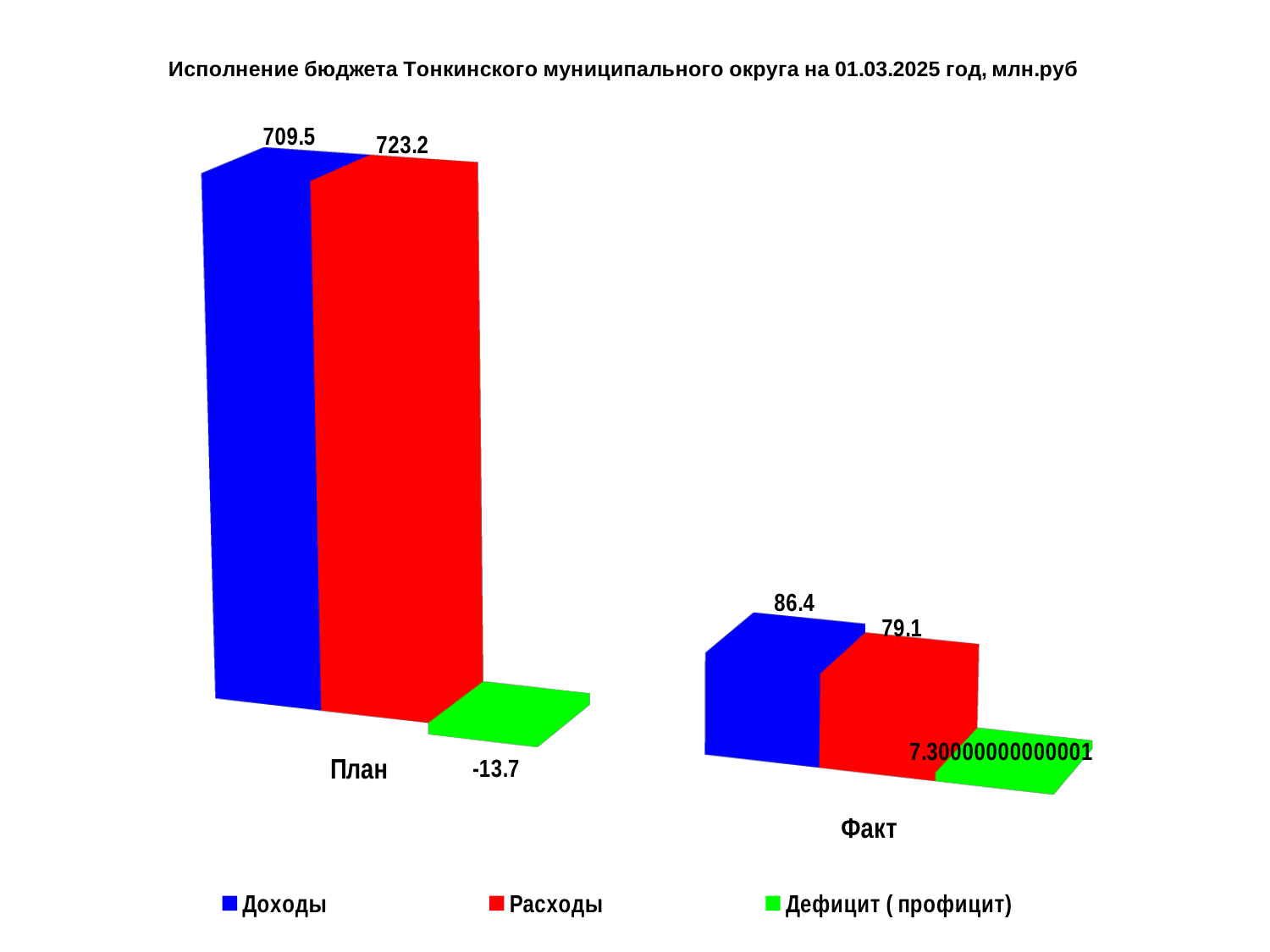
What is the value of Расходы for План? 723.2 What type of chart is shown on the slide? Bar chart What is the value of Дефицит ( профицит) for План? -13.7 What is the value of Расходы for Факт? 79.1 How many series does the legend list? 3 Which series has the lowest value in the Факт category? Дефицит ( профицит) Which is larger for Факт: Доходы or Расходы? Доходы What is the difference between Расходы and Доходы for План? 13.7 What is the value of Доходы for План? 709.5 What is the value of Доходы for Факт? 86.4 What is the difference between Доходы and Расходы for Факт? 7.3 Which series has the highest value in the План category? Расходы